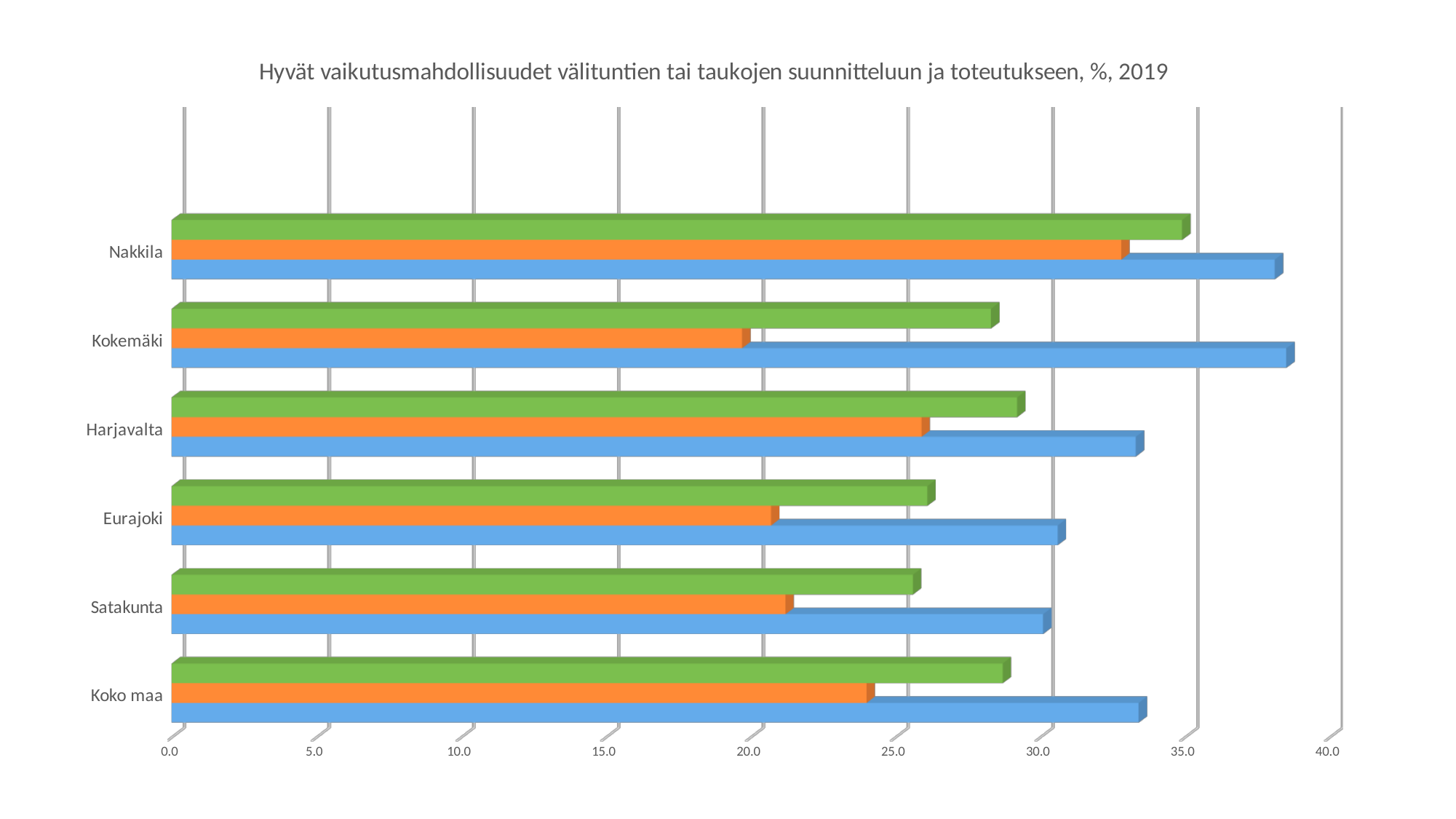
What is the highest value shown on the horizontal axis? 40.0 How many categories (municipalities/regions) are shown on the vertical axis? 6 Is the green bar for Satakunta greater or less than 30? less What kind of chart is shown on the slide? bar chart Is the orange bar for Eurajoki greater or less than 25? less Which category has the longest orange bar? Nakkila Which category has the longest green bar? Nakkila How many bars are plotted for each category? 3 What is the title of the chart? Hyvät vaikutusmahdollisuudet välituntien tai taukojen suunnitteluun ja toteutukseen, %, 2019 Which is larger, the blue bar for Harjavalta or the blue bar for Eurajoki? Harjavalta Is the blue bar for Kokemäki greater or less than 35? greater